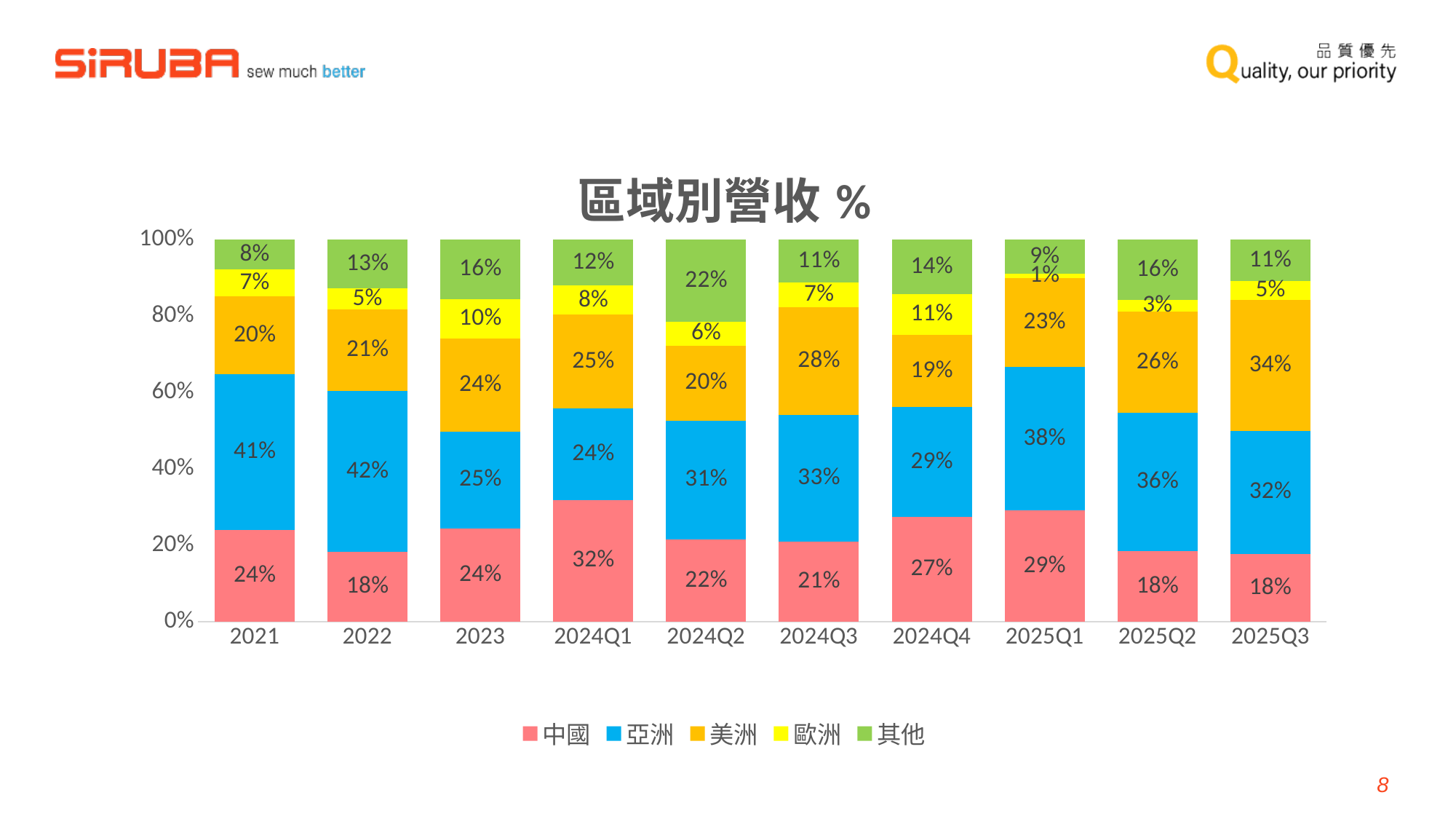
In which period is the 歐洲 share lowest? 2025Q1 What kind of chart is this? Stacked bar chart What is the value for 其他 in 2024Q2? 22% How many periods are shown on the x axis? 10 What is the value for 歐洲 in 2025Q1? 1% What is the difference between the 亞洲 share in 2022 and in 2023? 17% In which period is the 中國 share highest? 2024Q1 Which is larger in 2025Q3, the 亞洲 share or the 美洲 share? 美洲 What is the value for 中國 in 2024Q1? 32% How many series does the legend list? 5 What is the title of the chart? 區域別營收 % What is the value for 美洲 in 2025Q3? 34%